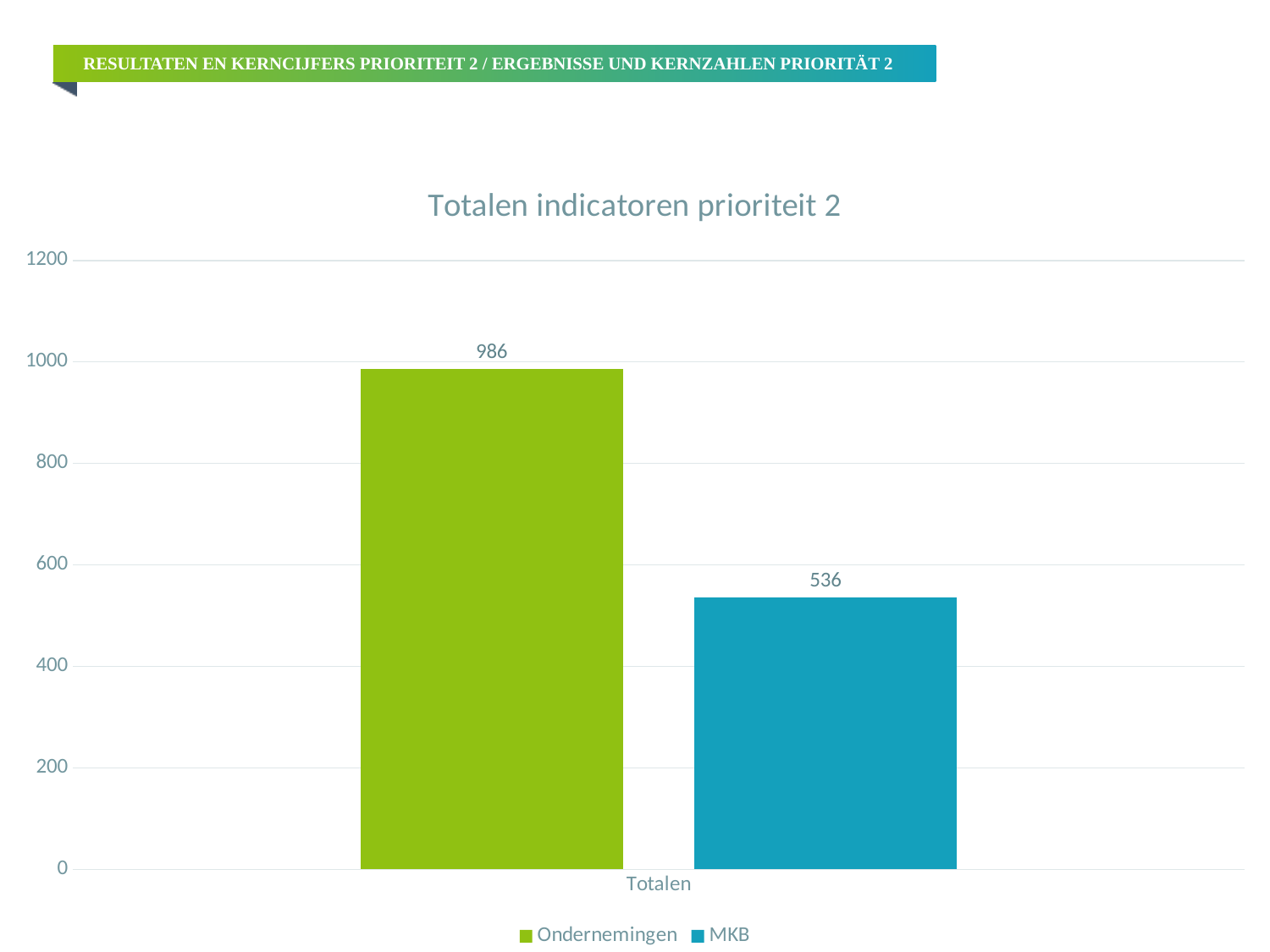
Is the value for Ondernemingen greater or less than 800? greater Which series has the highest value in the chart? Ondernemingen What is the difference between the Ondernemingen value and the MKB value? 450 Which series has the lowest value in the chart? MKB Which is larger, the value for Ondernemingen or the value for MKB? Ondernemingen What kind of chart is shown on the slide? bar chart What is the value for Ondernemingen in the chart? 986 How many series does the legend list? 2 What is the value for MKB in the chart? 536 Is the value for MKB greater or less than 600? less What is the category label on the x axis of the chart? Totalen What is the title of the chart? Totalen indicatoren prioriteit 2